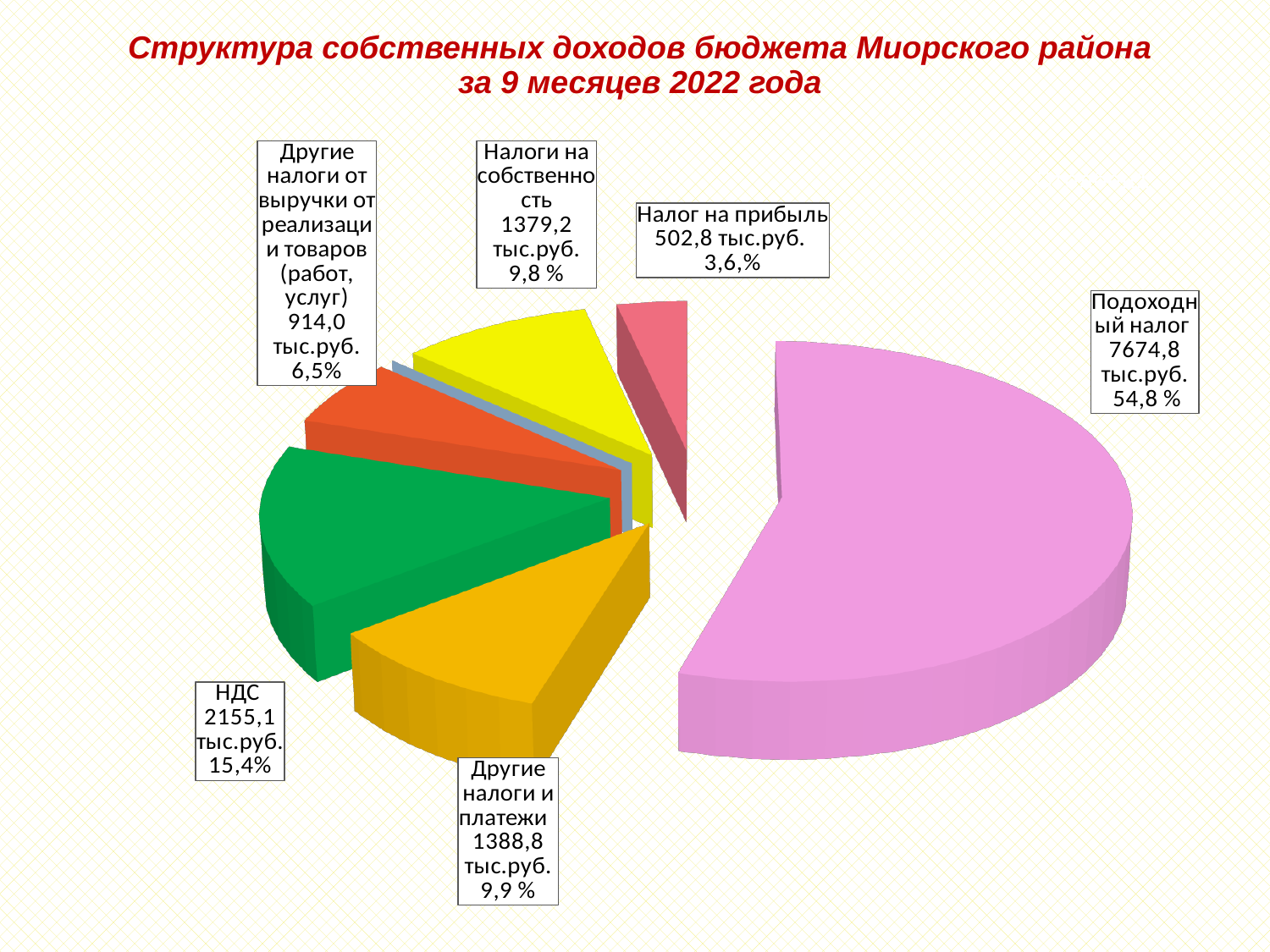
What is the difference in тыс.руб. between Подоходный налог and НДС? 5519,7 тыс.руб. What is the value for НДС in тыс.руб.? 2155,1 тыс.руб. Which labelled category has the smallest value? Налог на прибыль What is the value for Подоходный налог in тыс.руб.? 7674,8 тыс.руб. What is the value for Налог на прибыль in тыс.руб.? 502,8 тыс.руб. What share of the pie does НДС represent? 15,4% Which category has the largest slice of the pie? Подоходный налог What kind of chart is shown on the slide? pie chart What share of the pie does Подоходный налог represent? 54,8 % What is the title of the chart on the slide? Структура собственных доходов бюджета Миорского района за 9 месяцев 2022 года Which is larger: Другие налоги и платежи or Налоги на собственность? Другие налоги и платежи What is the value for Налоги на собственность in тыс.руб.? 1379,2 тыс.руб.